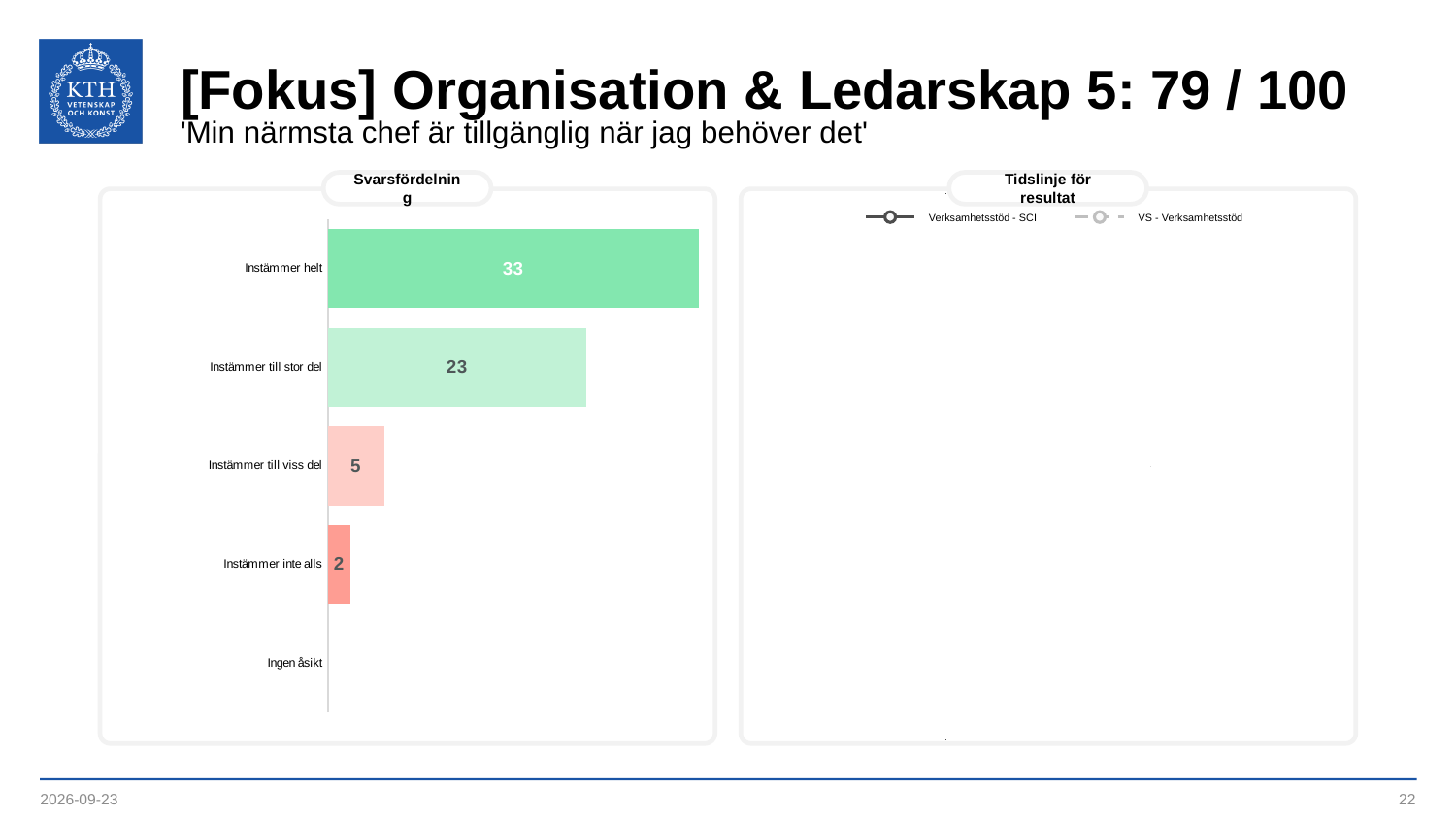
In the Svarsfördelning chart, what is the value for 'Instämmer helt'? 33 What is the title of the chart on the right side of the slide? Tidslinje för resultat In the Svarsfördelning chart, which is larger: 'Instämmer till viss del' or 'Instämmer inte alls'? Instämmer till viss del In the Svarsfördelning chart, which category has the highest value? Instämmer helt What kind of chart is the Svarsfördelning chart? Bar chart In the Svarsfördelning chart, what is the value for 'Instämmer till viss del'? 5 In the Svarsfördelning chart, which labelled bar has the lowest value? Instämmer inte alls In the Svarsfördelning chart, what is the value for 'Instämmer till stor del'? 23 How many series does the legend of the 'Tidslinje för resultat' chart list? 2 In the Svarsfördelning chart, what is the difference between 'Instämmer helt' and 'Instämmer till stor del'? 10 In the Svarsfördelning chart, what is the value for 'Instämmer inte alls'? 2 How many categories are listed on the axis of the Svarsfördelning chart? 5